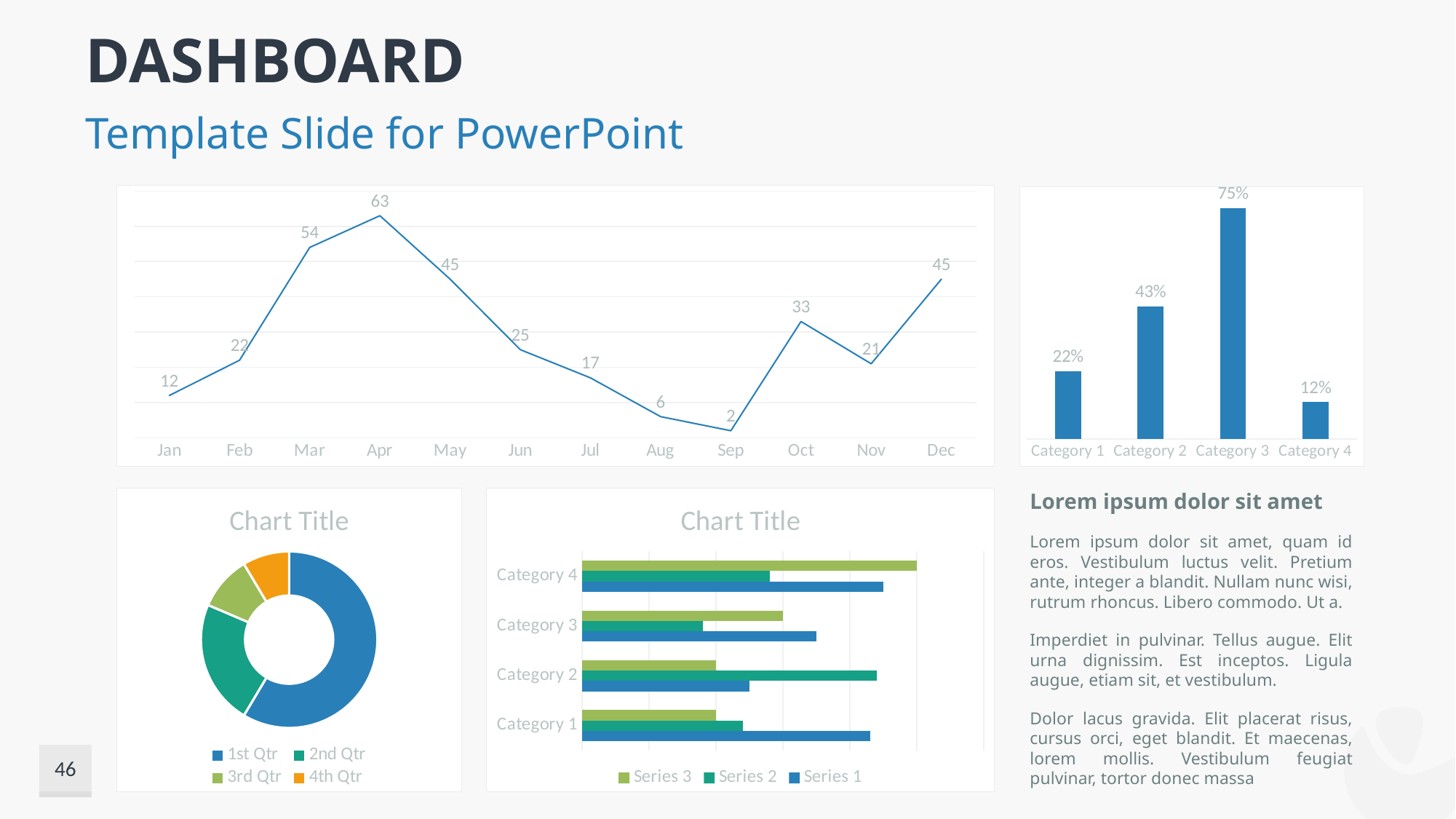
In the line chart at the top left, what is the value for Apr? 63 In the line chart at the top left, do the values rise or fall from Apr to Sep? fall In the line chart at the top left, how many months are plotted along the x axis? 12 In the doughnut chart at the bottom left, which legend entry corresponds to the largest slice? 1st Qtr In the bar chart at the top right, which category has the highest value? Category 3 In the line chart at the top left, which month has the lowest value? Sep In the horizontal bar chart at the bottom middle, how many series does the legend list? 3 In the horizontal bar chart at the bottom middle, for Category 2, which is larger: Series 2 or Series 3? Series 2 In the bar chart at the top right, what is the difference between Category 3 and Category 4? 63% In the line chart at the top left, what is the difference between the values for Mar and Feb? 32 In the doughnut chart at the bottom left, how many entries does the legend list? 4 In the bar chart at the top right, what is the value for Category 2? 43%